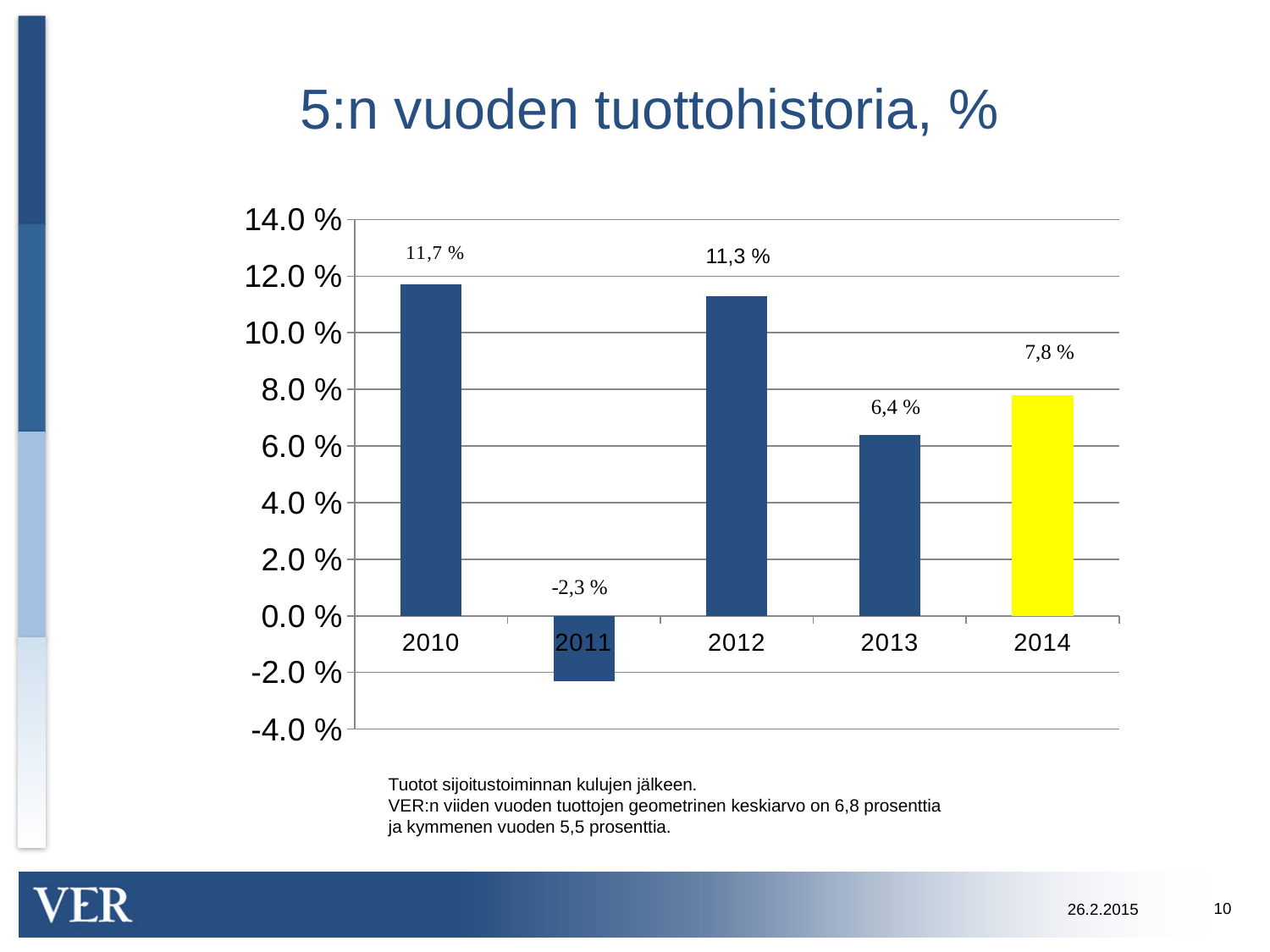
What is the value for 2011? -2,3 % Which is larger, the value for 2013 or the value for 2014? 2014 What is the difference between the values for 2012 and 2013? 4,9 % Which year has the lowest value? 2011 What is the value for 2013? 6,4 % What is the value for 2014? 7,8 % What kind of chart is shown on the slide? bar chart What is the value for 2010? 11,7 % Is the value for 2012 greater or less than 10.0 %? greater How many years are shown on the x axis? 5 What is the title of the chart? 5:n vuoden tuottohistoria, % Which year has the highest value? 2010